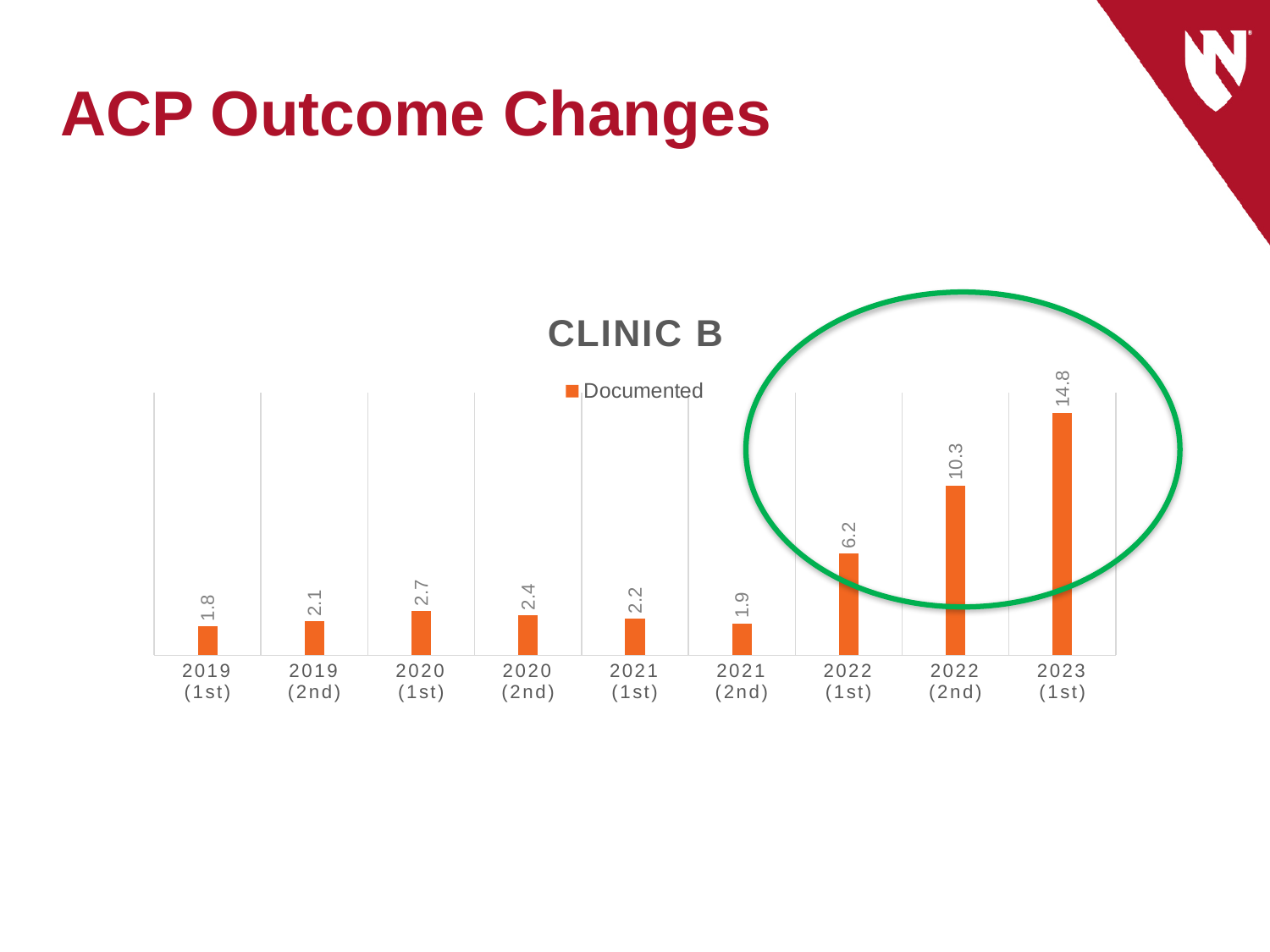
What is the title of the chart? CLINIC B What kind of chart is shown? Bar chart How many series does the legend list? 1 What is the difference between the Documented values for 2022 (1st) and 2021 (2nd)? 4.3 Which category has the highest Documented value? 2023 (1st) What is the difference between the Documented values for 2023 (1st) and 2022 (2nd)? 4.5 How many categories are shown on the x axis? 9 What is the Documented value for 2021 (2nd)? 1.9 Which is larger, the Documented value for 2020 (1st) or for 2020 (2nd)? 2020 (1st) What is the Documented value for 2022 (2nd)? 10.3 What is the Documented value for 2019 (1st)? 1.8 Which category has the lowest Documented value? 2019 (1st)